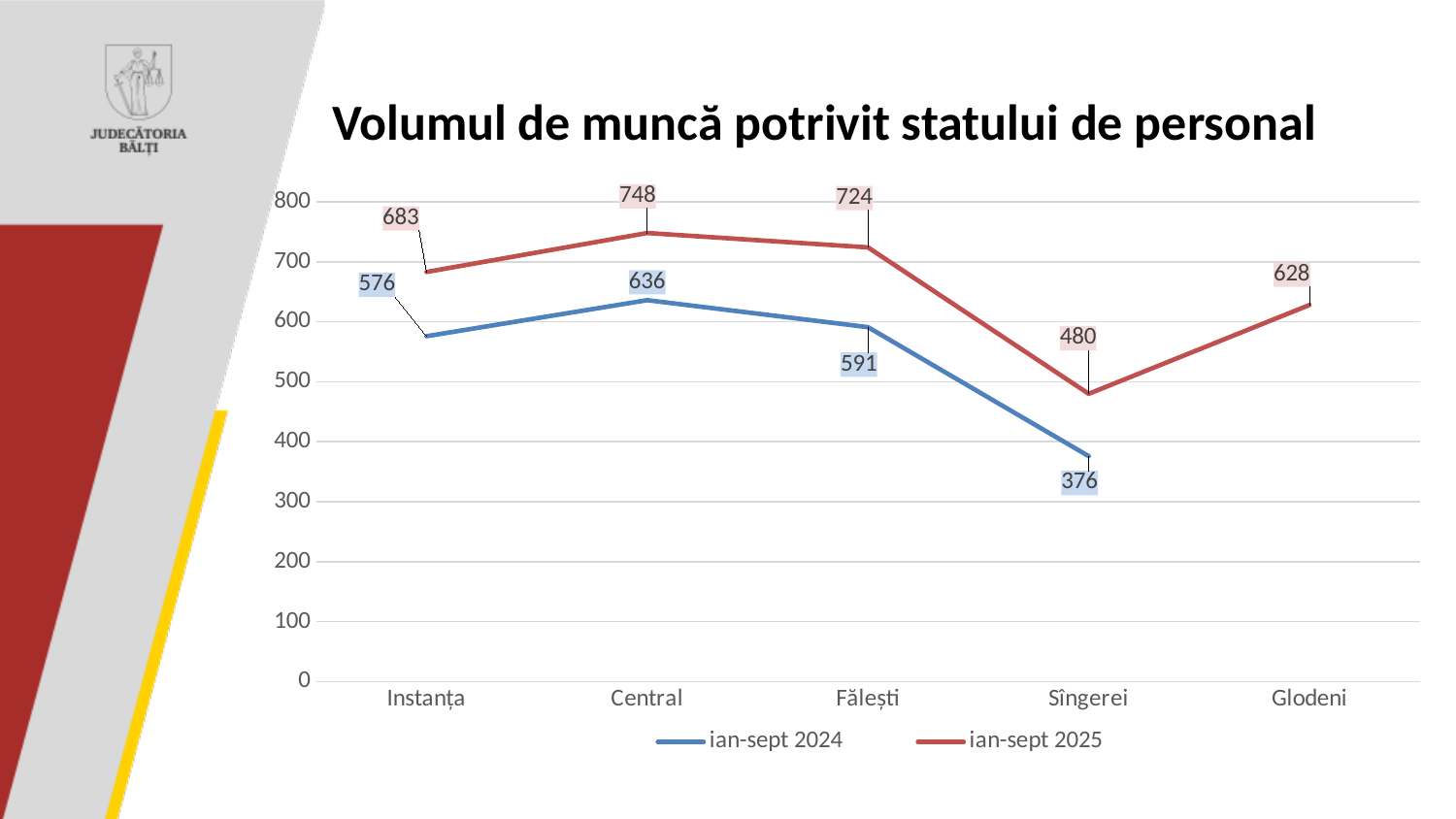
Is the value for Instanța in the ian-sept 2025 series greater or less than 700? less Which is larger for Sîngerei: the ian-sept 2024 value or the ian-sept 2025 value? ian-sept 2025 Which category has the highest value in the ian-sept 2025 series? Central How many series does the legend list? 2 What kind of chart is shown on the slide? line chart What is the value for Instanța in the ian-sept 2024 series? 576 What is the difference between the ian-sept 2025 and ian-sept 2024 values for Fălești? 133 What is the title of the chart? Volumul de muncă potrivit statului de personal What is the value for Glodeni in the ian-sept 2025 series? 628 What is the value for Central in the ian-sept 2025 series? 748 What is the value for Sîngerei in the ian-sept 2024 series? 376 Which category has the lowest value in the ian-sept 2024 series? Sîngerei